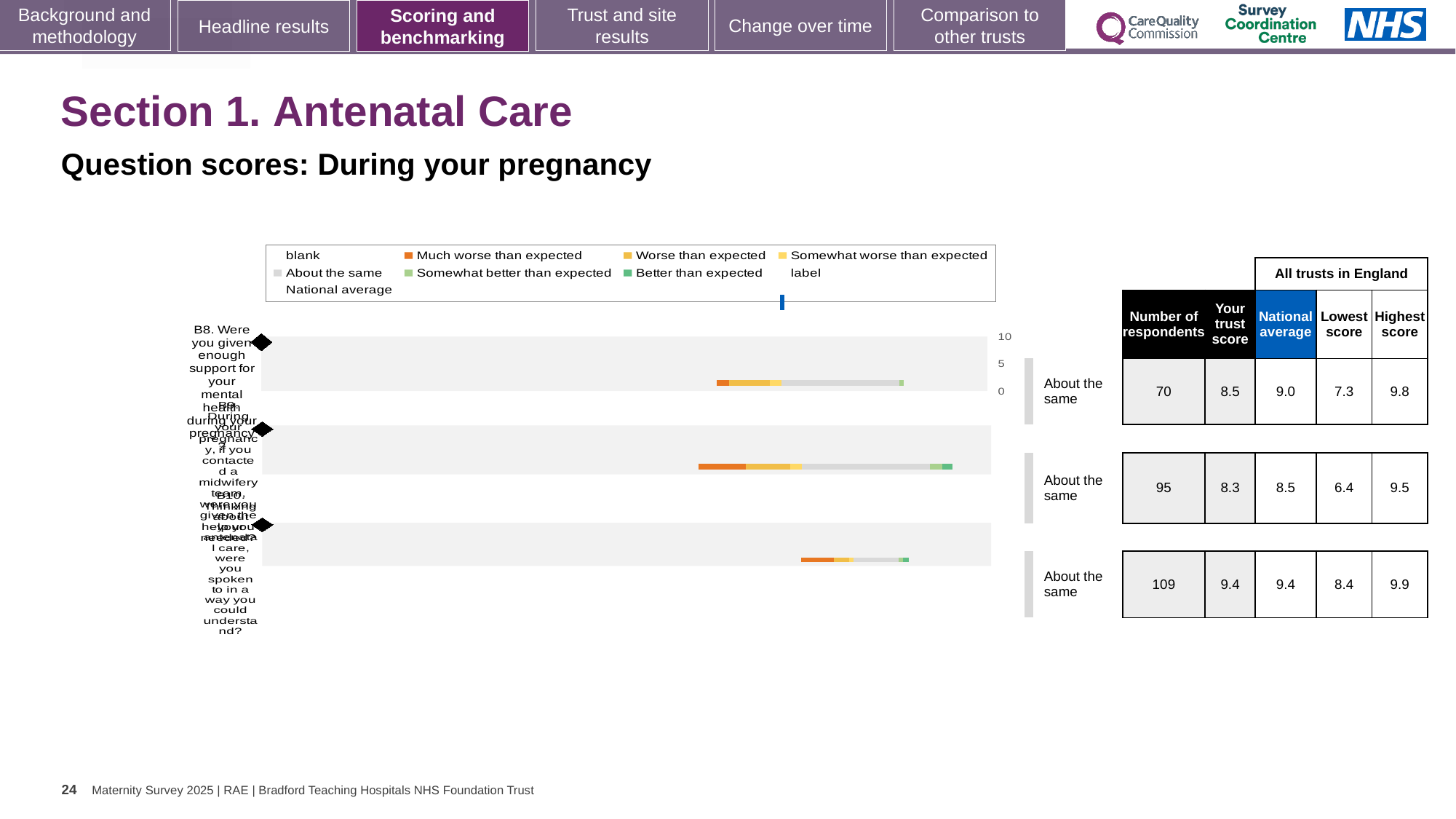
What is the trust's score for question B8 (support for your mental health during your pregnancy)? 8.5 What is the difference between the highest score and the lowest score for question B8? 2.5 What is the national average for question B8 (support for your mental health during your pregnancy)? 9.0 What is the highest value shown on the chart's numeric axis? 10 What is the lowest score among all trusts in England for the second question row? 6.4 What is the number of respondents for question B8 (support for your mental health during your pregnancy)? 70 What benchmark category is shown next to each of the three question rows? About the same What is the highest score among all trusts in England for the third question row? 9.9 How many survey questions (bars) are plotted in the chart? 3 What kind of chart is shown on the slide? bar chart Which question row has the largest number of respondents? the third row (109) For question B8, which is larger: the trust's score or the national average? the national average